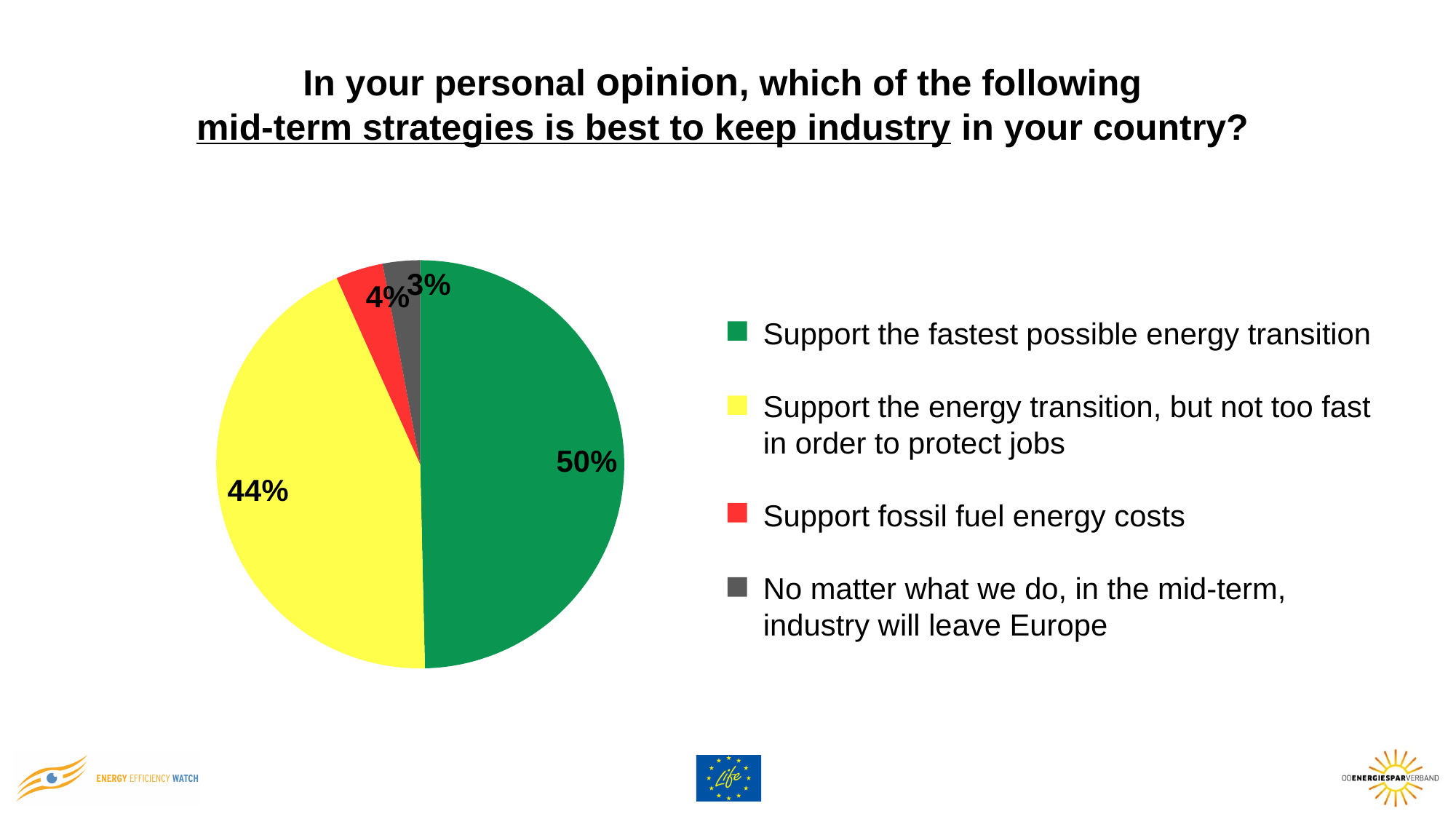
How many options are shown in the pie chart? 4 What type of chart is shown on the slide? Pie chart What is the difference in percentage points between 'Support the fastest possible energy transition' and 'Support the energy transition, but not too fast in order to protect jobs'? 6 percentage points What share of respondents chose 'Support the energy transition, but not too fast in order to protect jobs'? 44% What colour represents 'Support fossil fuel energy costs' in the pie chart? Red Which received a larger share: 'Support fossil fuel energy costs' or 'No matter what we do, in the mid-term, industry will leave Europe'? Support fossil fuel energy costs Which option received the largest share of responses? Support the fastest possible energy transition What share of respondents chose 'Support the fastest possible energy transition'? 50% What share of respondents chose 'Support fossil fuel energy costs'? 4% Which option received the smallest share of responses? No matter what we do, in the mid-term, industry will leave Europe What is the combined share of the two 'support the energy transition' options? 94% What share of respondents chose 'No matter what we do, in the mid-term, industry will leave Europe'? 3%